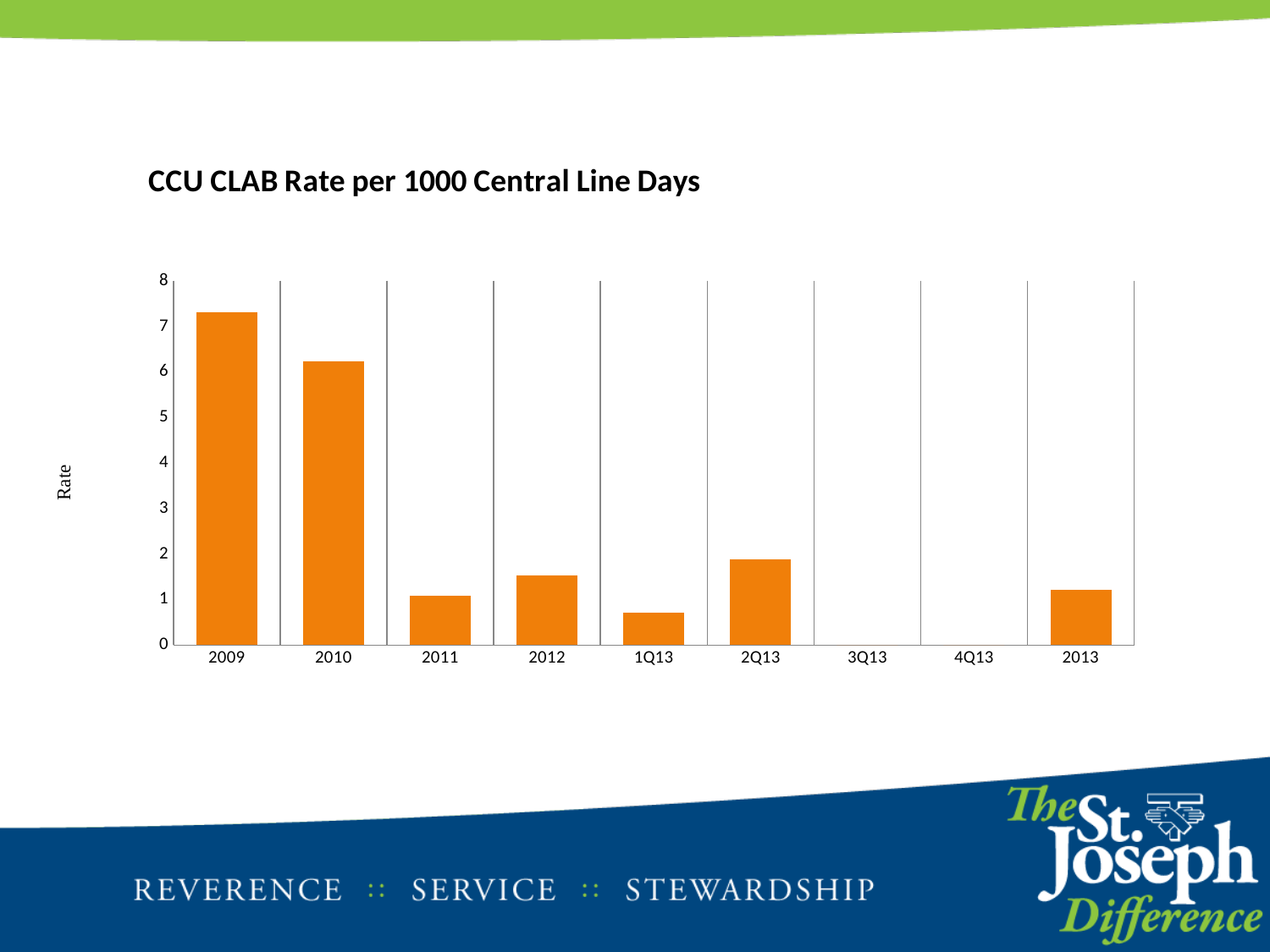
Is the value for 2009 greater or less than 6? greater Is the value for 2012 greater or less than 2? less Which is larger, the value for 2009 or the value for 2010? 2009 How many categories are shown on the x axis of the chart? 9 Is the value for 2010 greater or less than 7? less Which is larger, the value for 2Q13 or the value for 1Q13? 2Q13 What is the title of the chart? CCU CLAB Rate per 1000 Central Line Days Which category has the highest CCU CLAB rate? 2009 What is the label on the vertical axis of the chart? Rate What type of chart is shown on the slide? Bar chart Does the CCU CLAB rate rise or fall from 2009 to 2011? fall